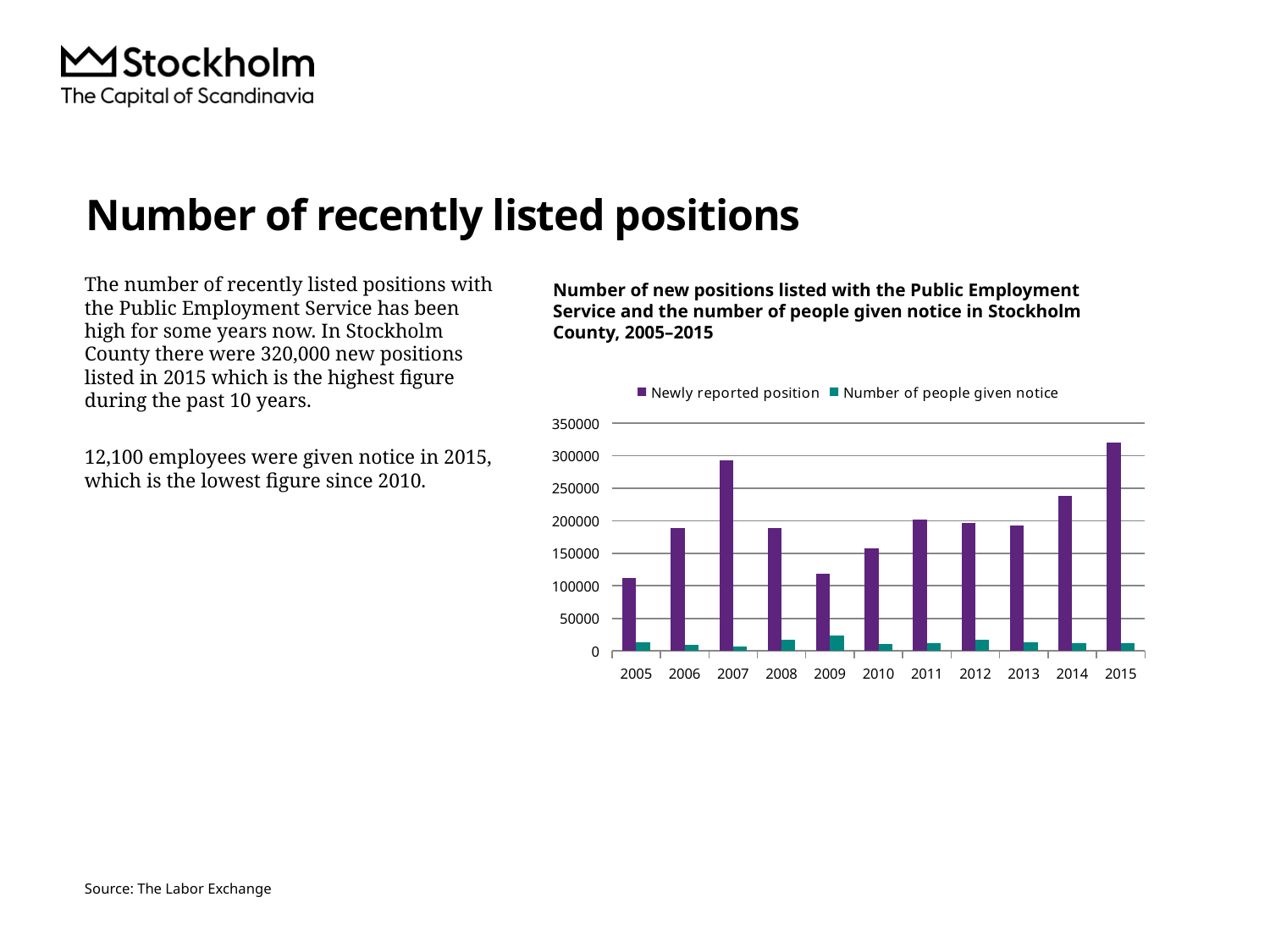
Is the number of newly reported positions in 2009 greater or less than 150000? less What kind of chart is shown on the slide? Bar chart In which year is the number of newly reported positions highest? 2015 Do the newly reported positions rise or fall from 2009 to 2011? rise How many series does the chart legend list? 2 Is the number of newly reported positions in 2014 greater or less than 200000? greater In which year is the number of people given notice lowest? 2007 How many years are shown on the x axis of the chart? 11 Is the number of newly reported positions in 2007 greater or less than 250000? greater Which colour represents the 'Newly reported position' series in the chart? Purple In which year is the number of people given notice highest? 2009 Which year had more newly reported positions, 2007 or 2014? 2007